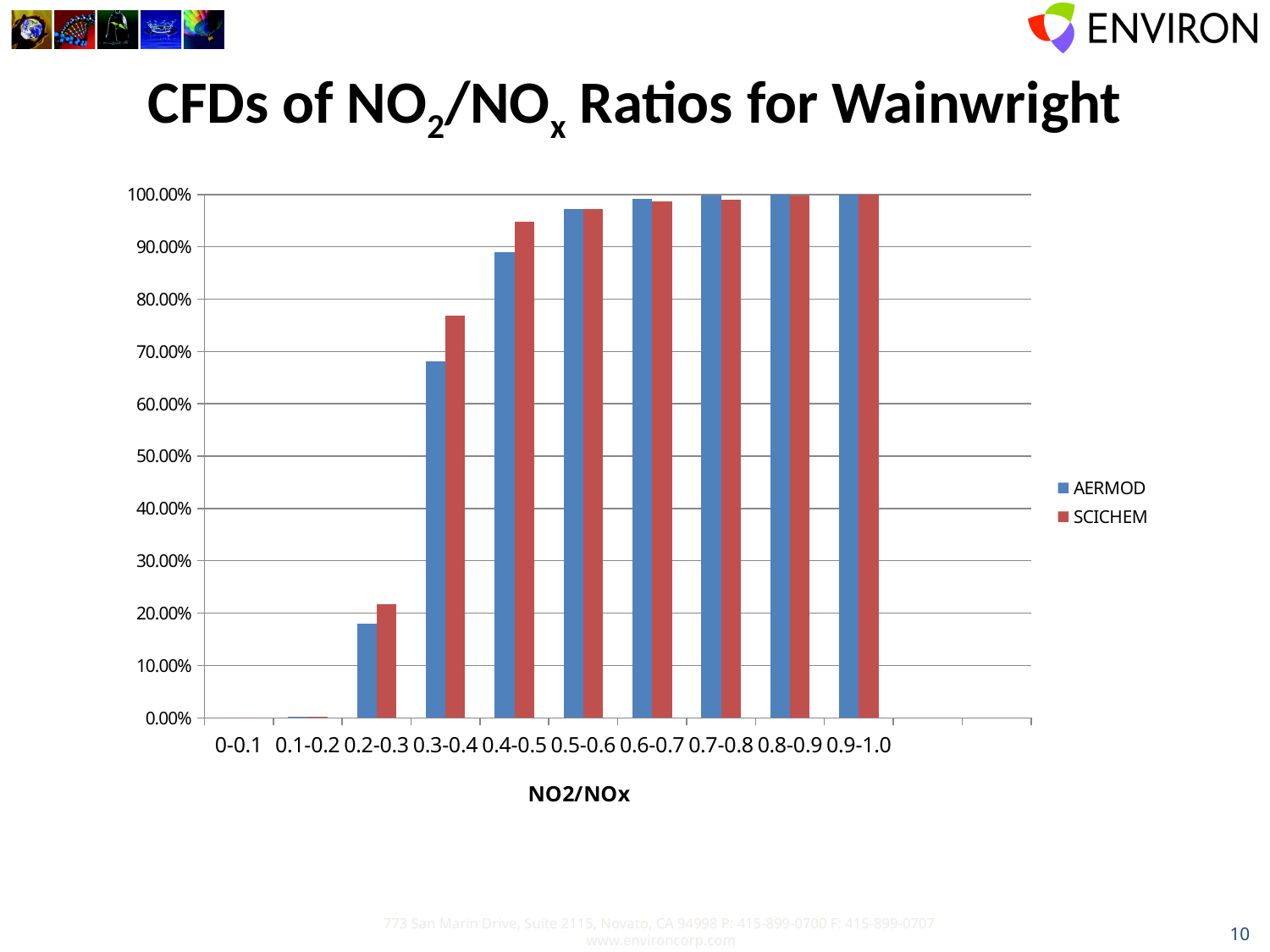
Is the AERMOD value for the 0.3-0.4 category greater or less than 70.00%? less Is the SCICHEM value for the 0.3-0.4 category greater or less than 70.00%? greater How many NO2/NOx ratio categories are shown on the x axis? 10 Do the values rise or fall as the NO2/NOx ratio increases along the x axis? rise Is the AERMOD value for the 0.2-0.3 category greater or less than 20.00%? less How many series does the legend list? 2 What kind of chart is shown on the slide? bar chart In the 0.3-0.4 category, which series has the larger value, AERMOD or SCICHEM? SCICHEM Which series is shown in red in the legend? SCICHEM